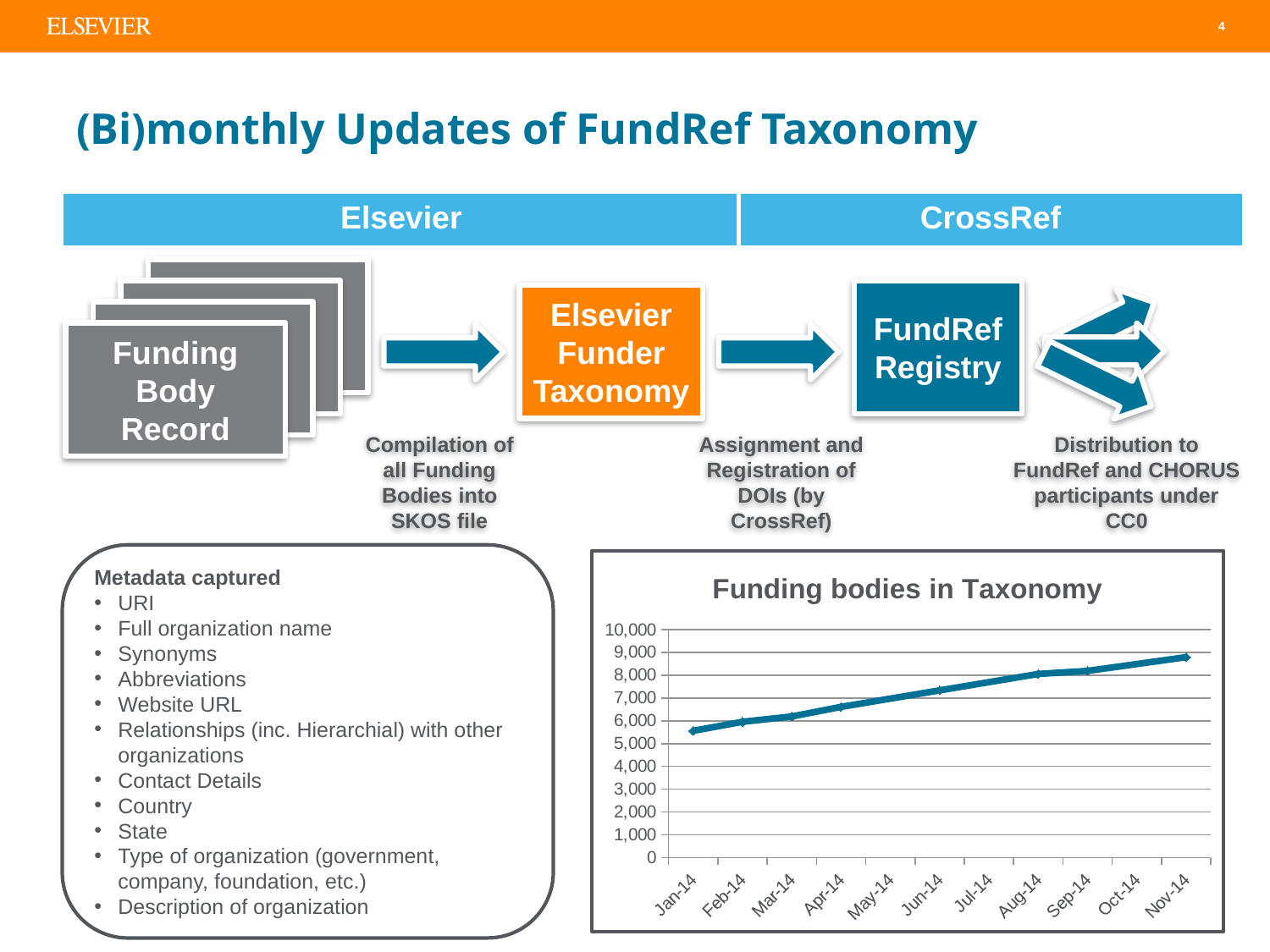
Is the value for Jan-14 greater or less than 6,000? less Is the value for Nov-14 greater or less than 8,000? greater What is the highest value shown on the y axis of the "Funding bodies in Taxonomy" chart? 10,000 Which month has the highest value in the "Funding bodies in Taxonomy" chart? Nov-14 Do the values in the "Funding bodies in Taxonomy" chart rise or fall from Jan-14 to Nov-14? rise What is the title of the chart on the slide? Funding bodies in Taxonomy How many months are plotted on the x axis of the "Funding bodies in Taxonomy" chart? 11 Which month has the lowest value in the "Funding bodies in Taxonomy" chart? Jan-14 What kind of chart is "Funding bodies in Taxonomy"? line chart Is the value for Jun-14 greater or less than 7,000? greater Which is larger, the value for Mar-14 or the value for Sep-14? Sep-14